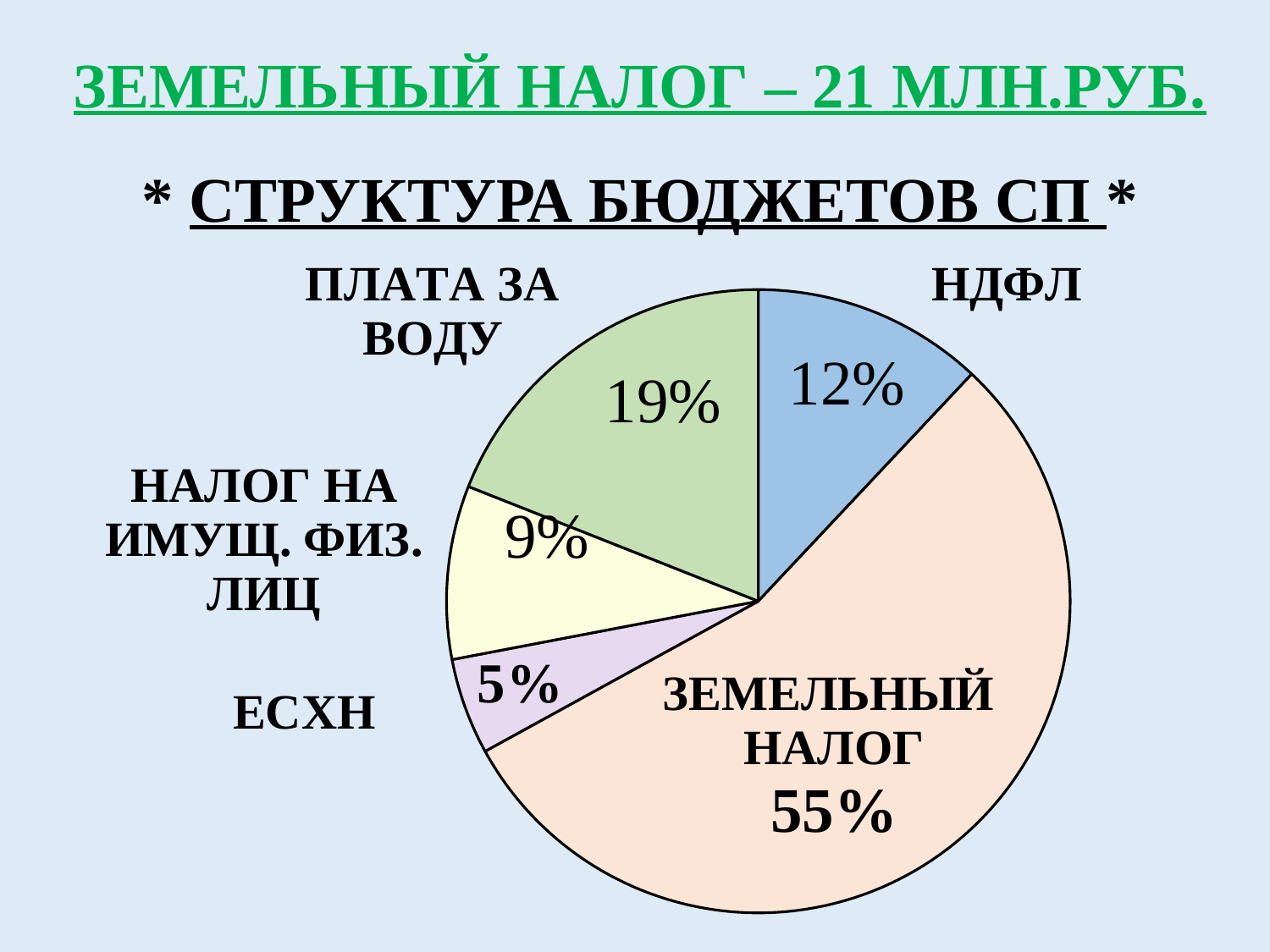
Which category has the smallest slice of the pie? ЕСХН What is the title of the pie chart? * СТРУКТУРА БЮДЖЕТОВ СП * What share of the pie does ПЛАТА ЗА ВОДУ have? 19% What kind of chart is shown on the slide? Pie chart Which category has the largest slice of the pie? ЗЕМЕЛЬНЫЙ НАЛОГ What share of the pie does НДФЛ have? 12% What share of the pie does НАЛОГ НА ИМУЩ. ФИЗ. ЛИЦ have? 9% Which is larger, the share for НДФЛ or the share for НАЛОГ НА ИМУЩ. ФИЗ. ЛИЦ? НДФЛ How many slices does the pie chart have? 5 What is the difference in percentage points between ПЛАТА ЗА ВОДУ and НДФЛ? 7